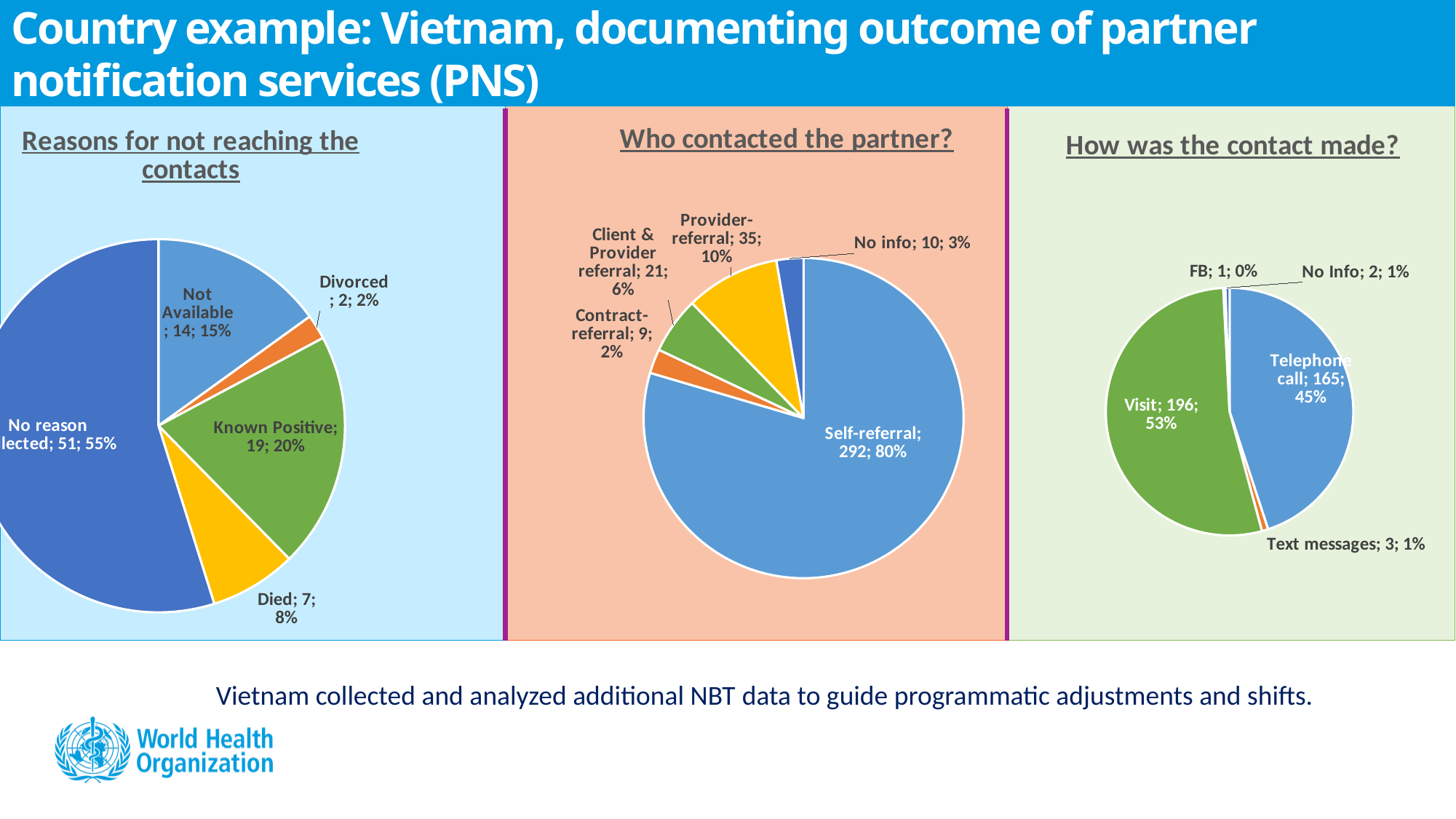
In the 'How was the contact made?' chart, which category has the smallest slice? FB In the 'Who contacted the partner?' chart, what is the difference in count between Provider-referral and Client & Provider referral? 14 In the 'How was the contact made?' chart, what share of contacts were made by Visit? 53% In the 'How was the contact made?' chart, what is the difference in count between Visit and Telephone call? 31 In the 'Who contacted the partner?' chart, what value is shown for Self-referral? 292; 80% In the 'Reasons for not reaching the contacts' chart, what percentage is shown for Divorced? 2% How many slices does the 'Who contacted the partner?' chart have? 5 What type of chart is used in the 'How was the contact made?' panel? Pie chart In the 'Reasons for not reaching the contacts' chart, which is larger: Not Available or Died? Not Available In the 'Who contacted the partner?' chart, which category has the largest slice? Self-referral In the 'Reasons for not reaching the contacts' chart, what is the count for Known Positive? 19 What is the title of the chart in the middle panel of the slide? Who contacted the partner?